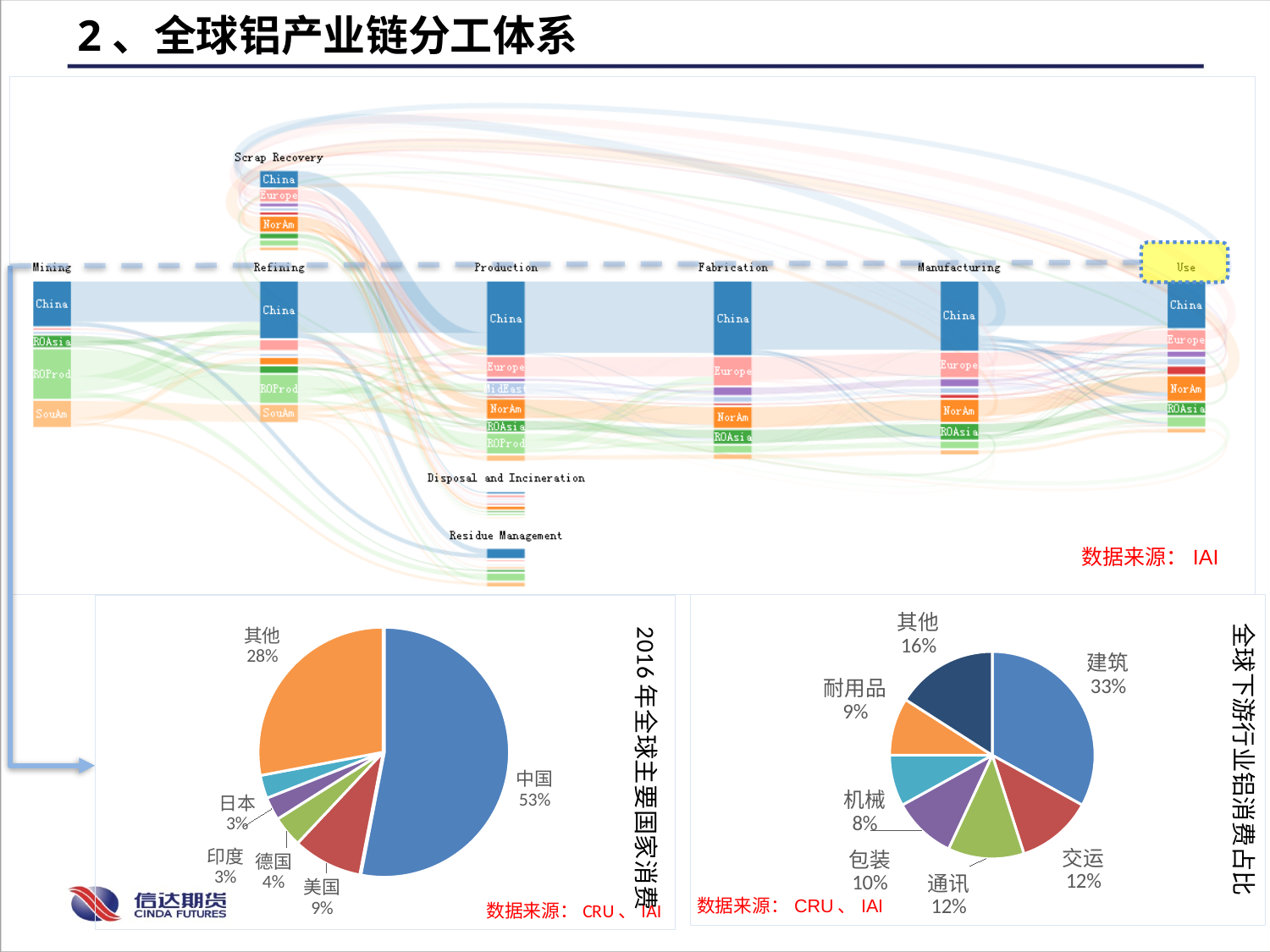
In the pie chart titled 2016年全球主要国家消费, which category has the largest share? 中国 In the pie chart titled 全球下游行业铝消费占比, what share does 建筑 have? 33% In the pie chart titled 全球下游行业铝消费占比, what is the difference between the shares of 建筑 and 交运? 21% In the pie chart titled 2016年全球主要国家消费, how many slices are there? 6 In the pie chart titled 2016年全球主要国家消费, what share does 中国 have? 53% In the pie chart titled 2016年全球主要国家消费, which is larger, the share of 德国 or the share of 美国? 美国 In the pie chart titled 2016年全球主要国家消费, what is the difference between the shares of 中国 and 其他? 25% In the pie chart titled 2016年全球主要国家消费, what share does 美国 have? 9% In the pie chart titled 全球下游行业铝消费占比, how many slices are there? 7 What type of chart is used for 全球下游行业铝消费占比 at the bottom right of the slide? Pie chart In the pie chart titled 全球下游行业铝消费占比, which category has the smallest share? 机械 In the pie chart titled 全球下游行业铝消费占比, what share does 包装 have? 10%